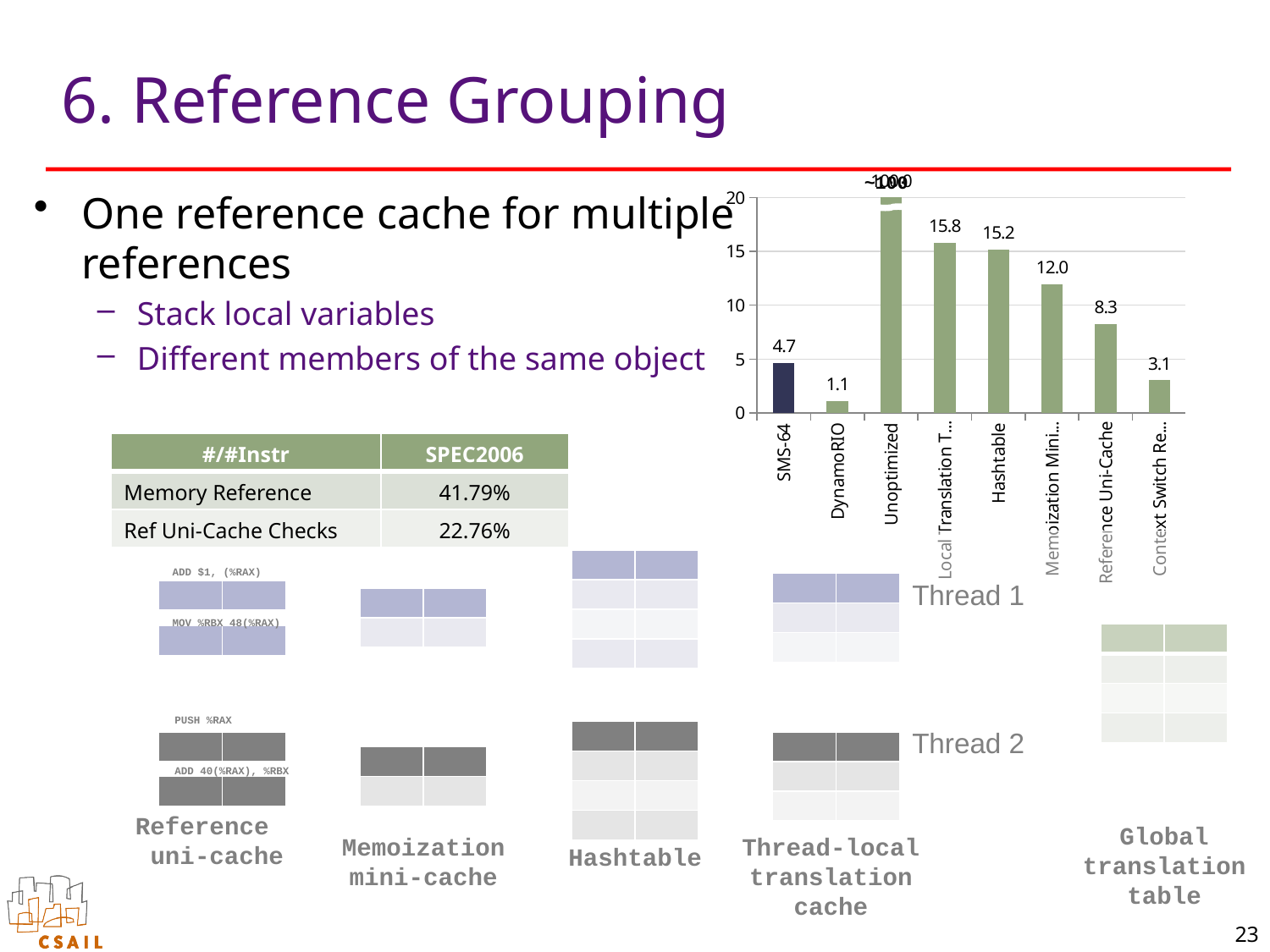
What is the value for Reference Uni-Cache? 8.3 How many bars are shown in the chart? 8 Which category has the lowest value? DynamoRIO What kind of chart is shown on the slide? Bar chart What is the value for DynamoRIO? 1.1 What is the value for the bar labelled "Memoization Mini..."? 12.0 Which is larger, the value for SMS-64 or the value for DynamoRIO? SMS-64 Is the value for Hashtable greater or less than 10? greater What is the value for SMS-64? 4.7 Which category has the highest value? Unoptimized What is the value for Hashtable? 15.2 What is the difference between the Hashtable value and the Reference Uni-Cache value? 6.9